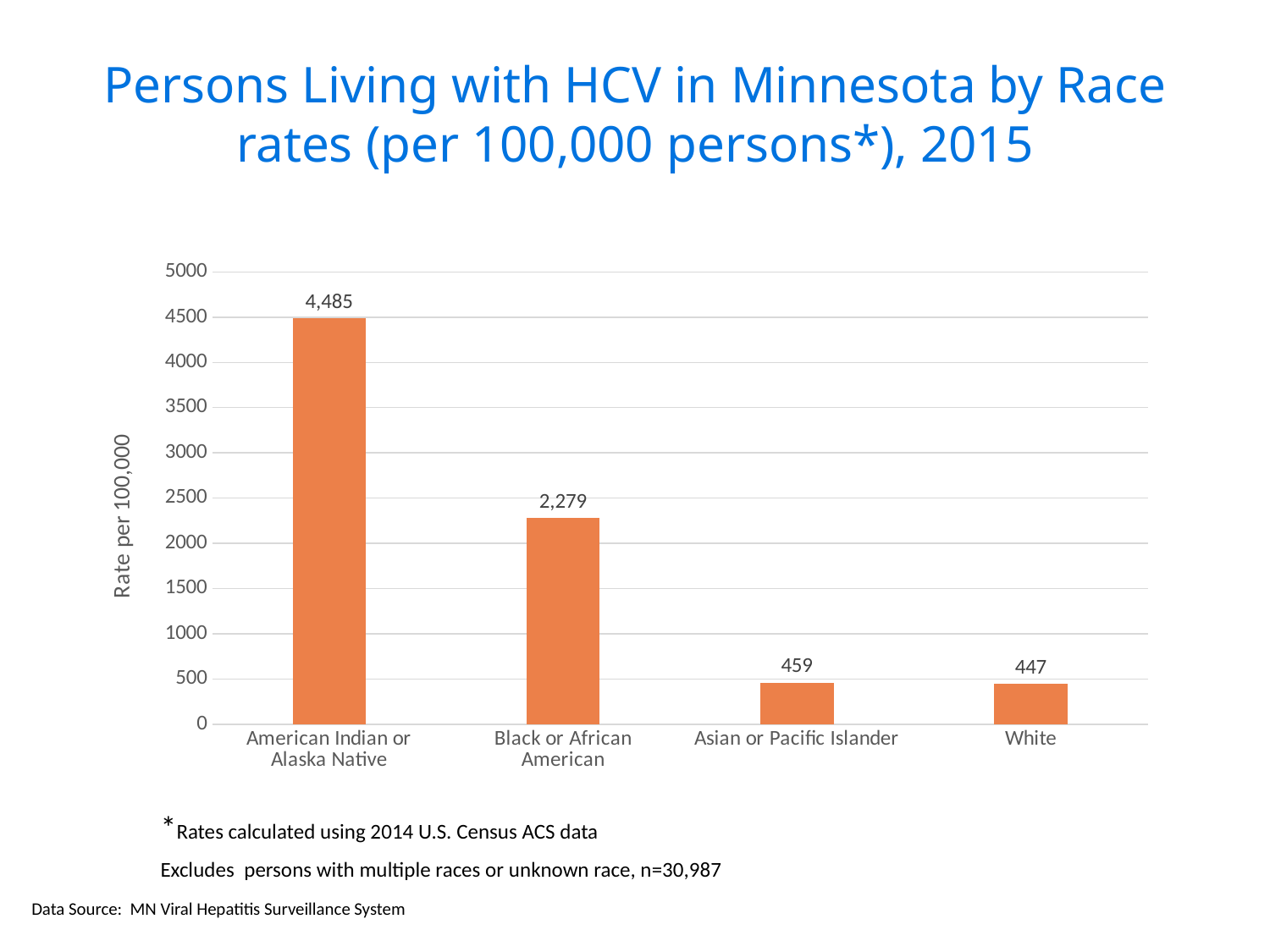
What is the rate per 100,000 for Asian or Pacific Islander? 459 Which race category has the highest rate? American Indian or Alaska Native What kind of chart is shown on the slide? Bar chart How many race categories are shown on the chart? 4 Which is larger, the rate for Black or African American or the rate for Asian or Pacific Islander? Black or African American What is the rate per 100,000 for Black or African American? 2,279 What is the difference between the rates for American Indian or Alaska Native and Black or African American? 2,206 Is the rate for Black or African American greater or less than 2000? greater Which race category has the lowest rate? White What is the difference between the rates for Asian or Pacific Islander and White? 12 What is the rate per 100,000 for American Indian or Alaska Native? 4,485 What is the rate per 100,000 for White? 447